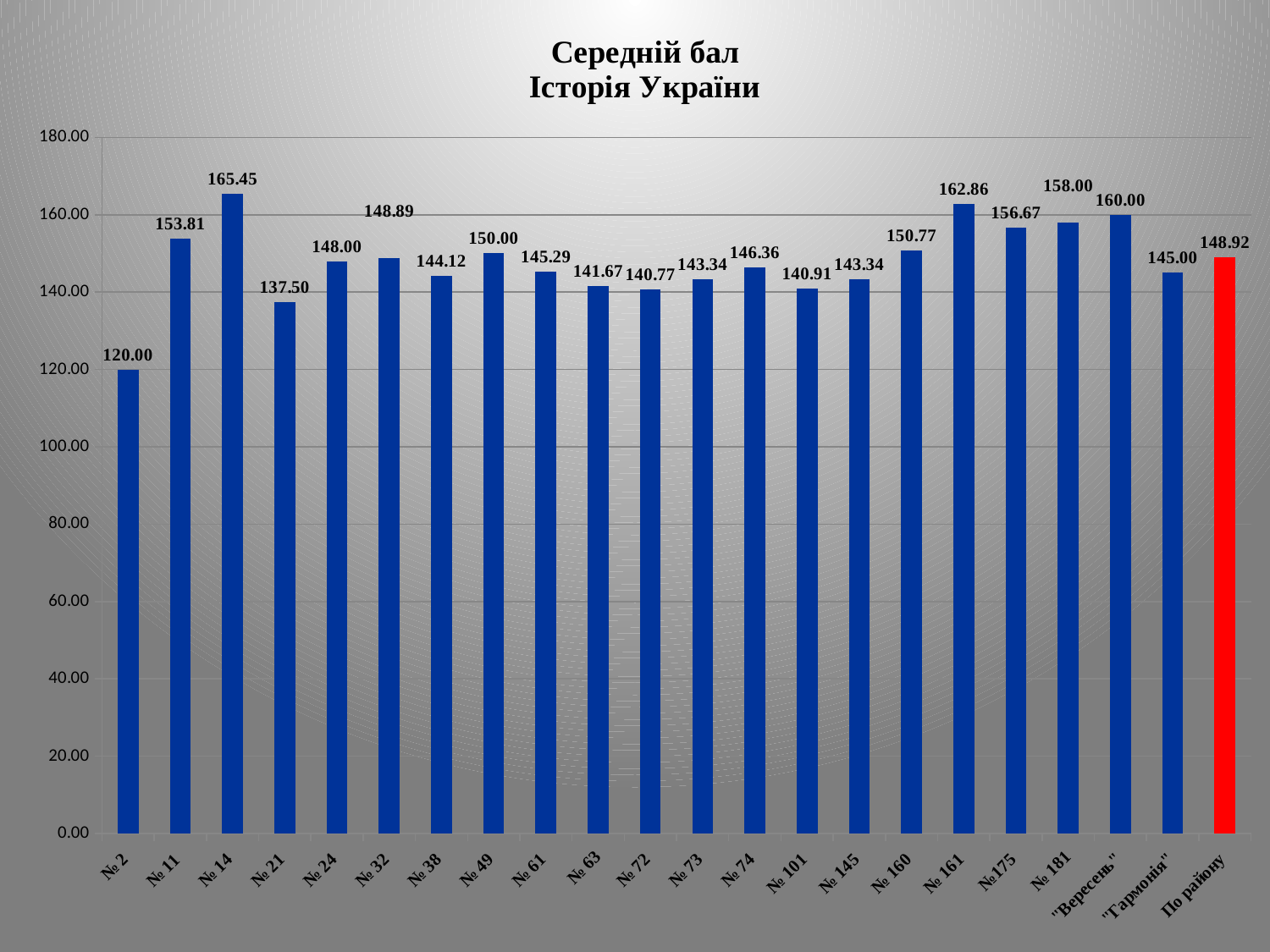
What is the value for По району? 148.92 Is the value for № 2 greater or less than 140.00? less Which category has the highest value? № 14 What is the difference between the values for "Вересень" and "Гармонія"? 15.00 What kind of chart is shown on the slide? bar chart Which category has the lowest value? № 2 Which is larger, the value for № 11 or the value for № 21? № 11 What is the value for "Гармонія"? 145.00 What is the value for № 14? 165.45 What is the difference between the values for № 14 and № 2? 45.45 What colour is the bar for По району? red How many categories are shown on the x axis? 22